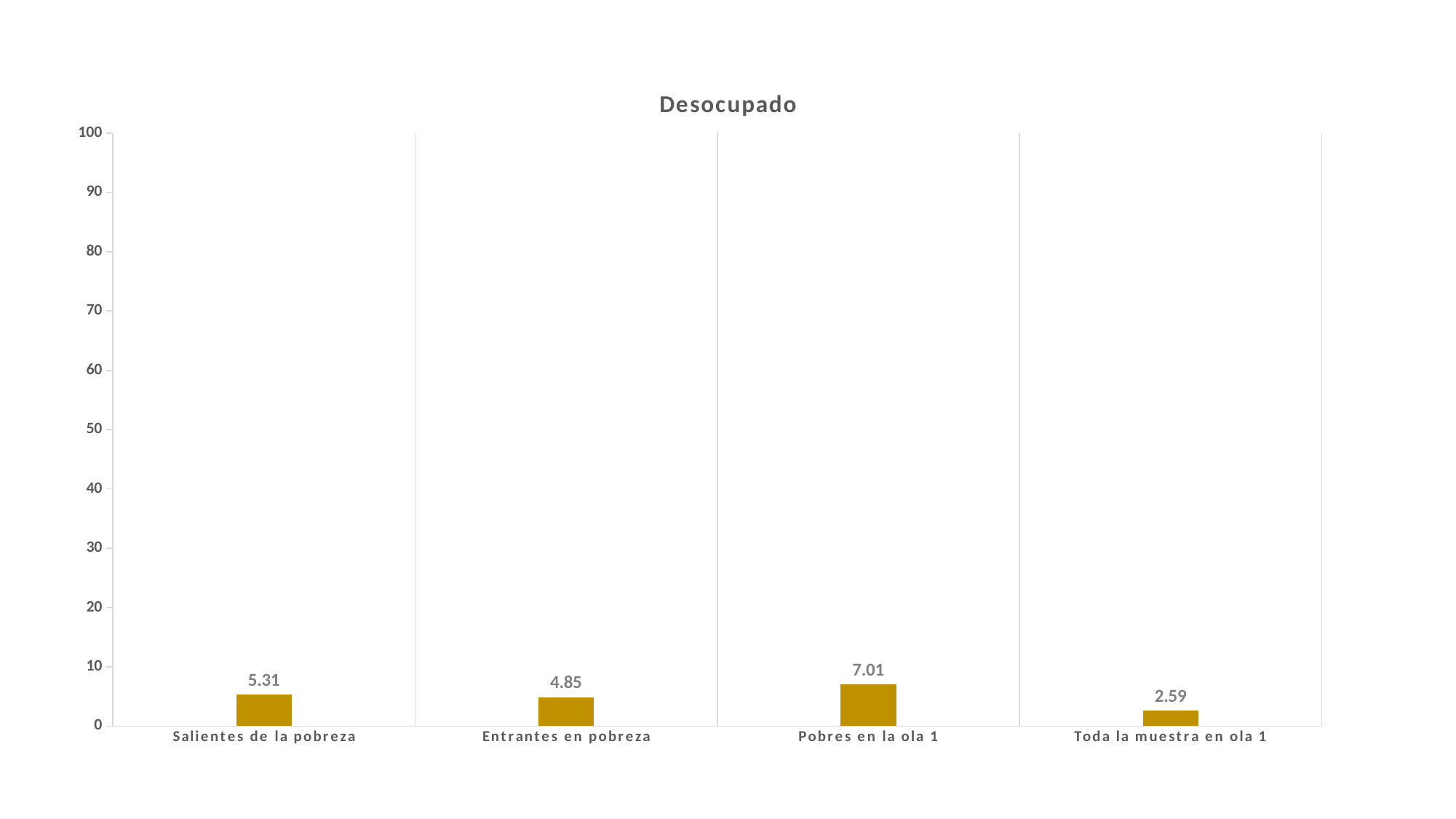
What is the value for Pobres en la ola 1? 7.01 Which is larger, the value for Salientes de la pobreza or the value for Entrantes en pobreza? Salientes de la pobreza Which category has the highest value? Pobres en la ola 1 What is the title of the chart? Desocupado What is the value for Salientes de la pobreza? 5.31 What is the value for Toda la muestra en ola 1? 2.59 What is the value for Entrantes en pobreza? 4.85 How many categories are shown on the x axis? 4 Which category has the lowest value? Toda la muestra en ola 1 What is the difference between the values for Pobres en la ola 1 and Toda la muestra en ola 1? 4.42 Is the value for Pobres en la ola 1 greater or less than 10? less What kind of chart is shown on the slide? bar chart